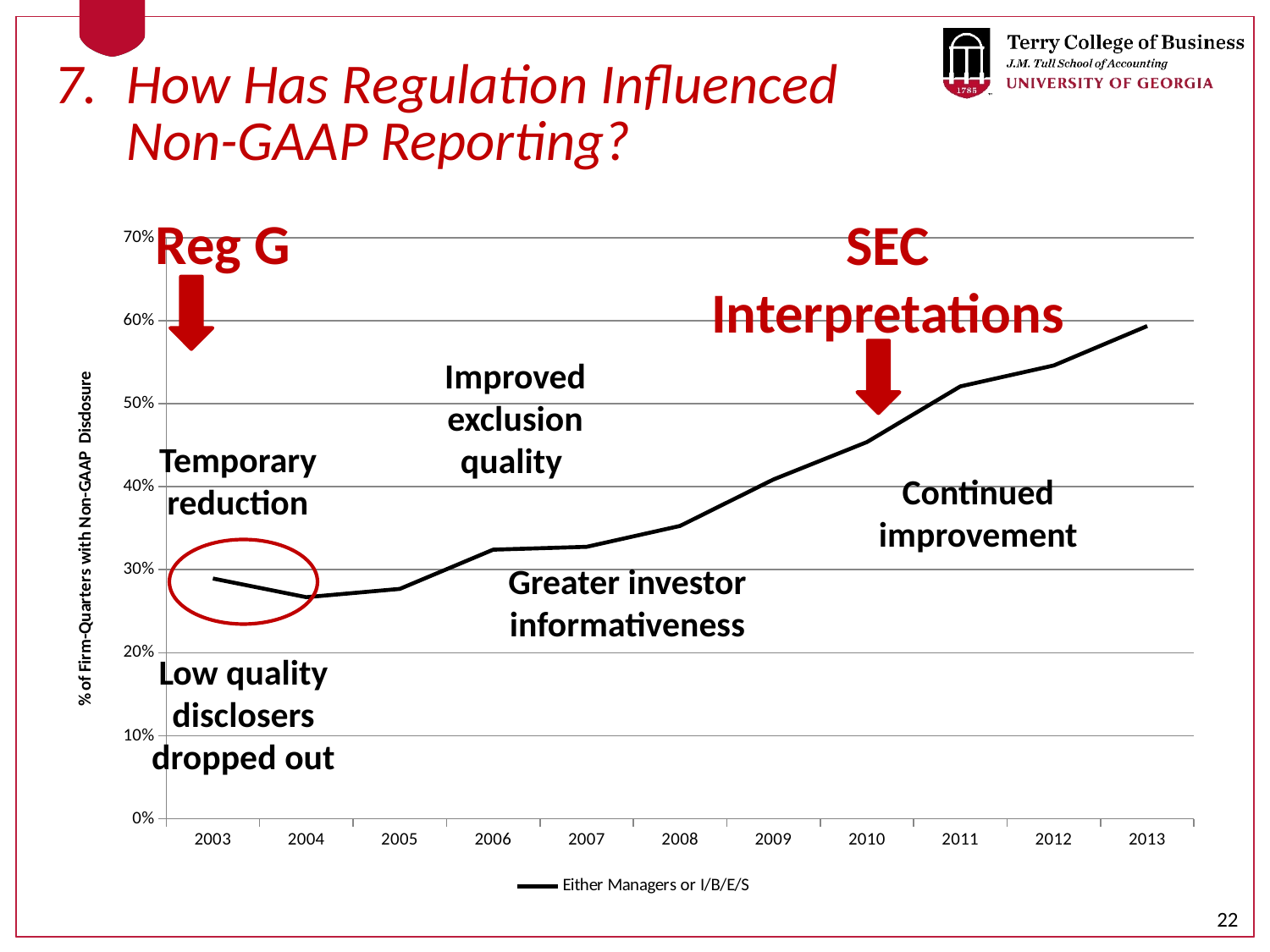
In which year is the plotted value highest? 2013 Overall, do the values rise or fall from 2005 to 2013? rise Is the value for 2013 greater or less than 50%? greater What kind of chart is shown on the slide? line chart How many series does the chart's legend list? 1 How many years are plotted along the x axis of the chart? 11 Which year has the larger value, 2006 or 2011? 2011 In which year is the plotted value lowest? 2004 What is the name of the series shown in the chart's legend? Either Managers or I/B/E/S Is the value for 2004 greater or less than 30%? less What is the title of the chart's vertical axis? % of Firm-Quarters with Non-GAAP Disclosure